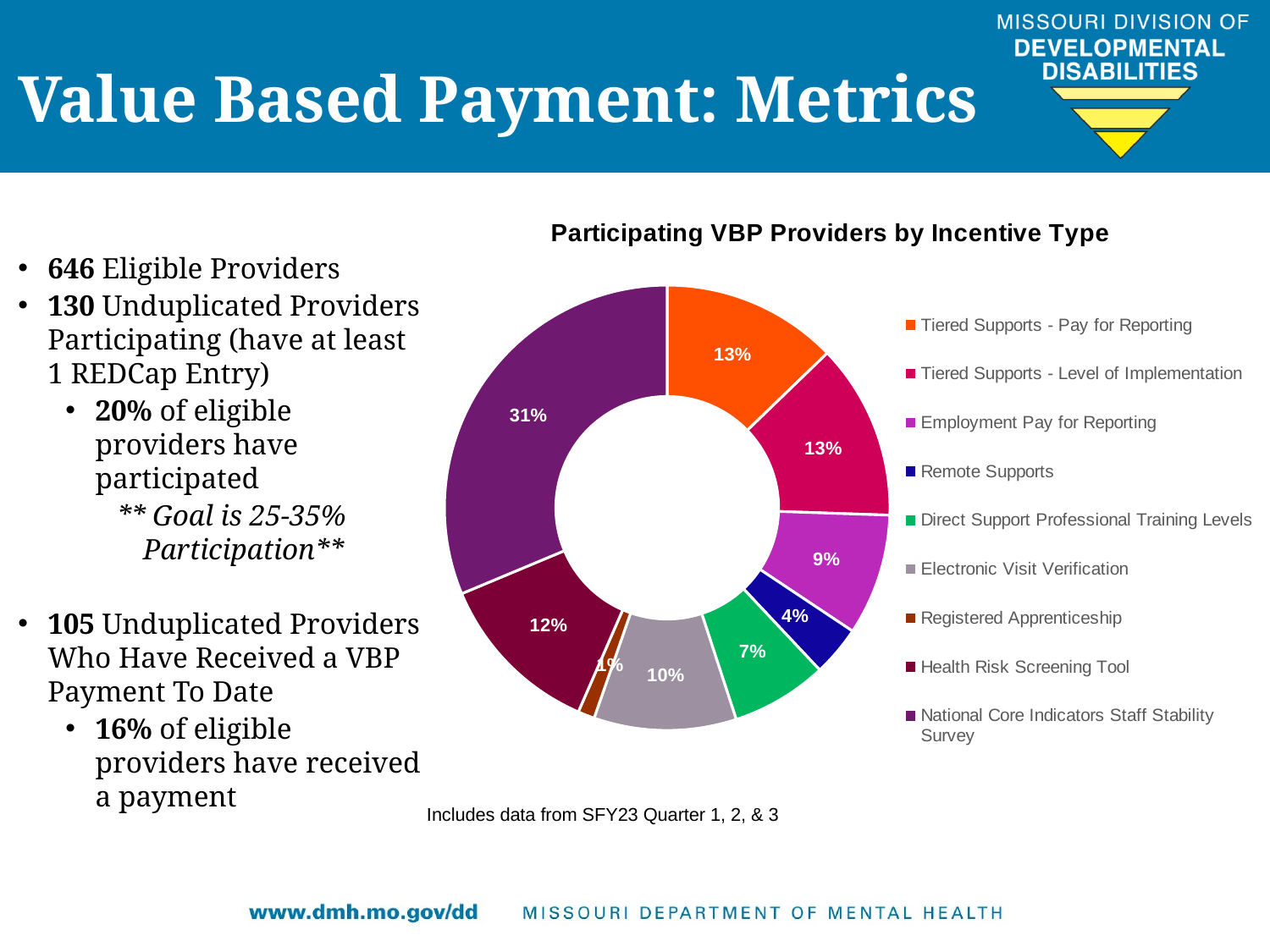
What percentage of participating VBP providers is shown for National Core Indicators Staff Stability Survey? 31% Which incentive type has the largest share of participating VBP providers? National Core Indicators Staff Stability Survey What note appears below the chart about the data period? Includes data from SFY23 Quarter 1, 2, & 3 What is the title of the chart? Participating VBP Providers by Incentive Type What is the difference in percentage points between Employment Pay for Reporting and Direct Support Professional Training Levels? 2 percentage points Which has a larger share: Electronic Visit Verification or Health Risk Screening Tool? Health Risk Screening Tool What percentage is shown for Remote Supports? 4% What percentage is shown for Health Risk Screening Tool? 12% Which incentive type has the smallest share of participating VBP providers? Registered Apprenticeship How many incentive types does the legend list? 9 What type of chart is shown on the slide? Doughnut chart What percentage is shown for Electronic Visit Verification? 10%